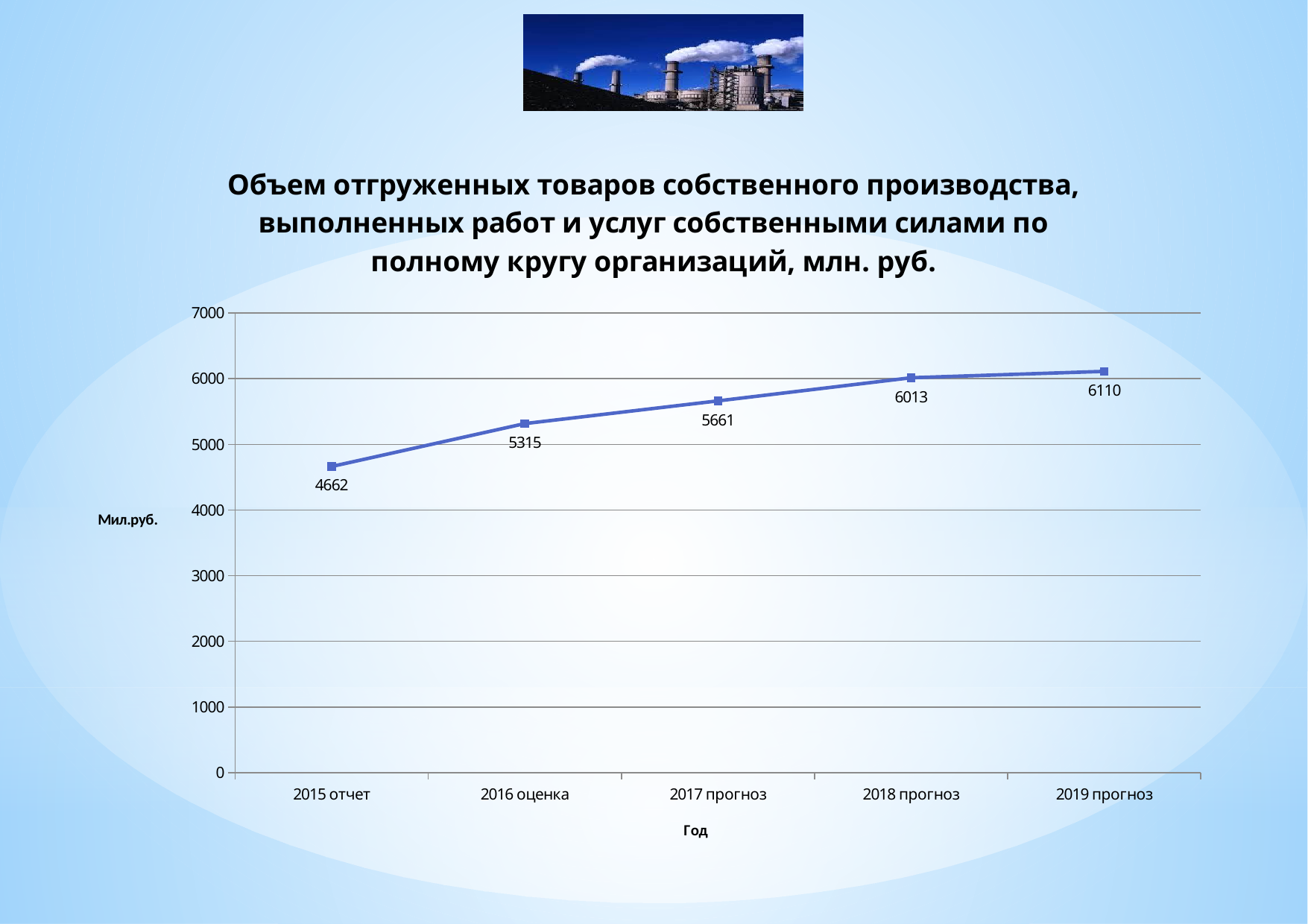
Which year has the lowest value? 2015 отчет How many data points are plotted on the chart? 5 Do the values rise or fall from 2015 to 2019? rise What is the value for 2017 прогноз? 5661 Which year has the highest value? 2019 прогноз What is the value for 2015 отчет? 4662 What kind of chart is shown on the slide? line chart Which is larger, the value for 2017 прогноз or the value for 2016 оценка? 2017 прогноз What is the difference between the values for 2016 оценка and 2015 отчет? 653 What is the difference between the values for 2019 прогноз and 2018 прогноз? 97 Is the value for 2018 прогноз greater or less than 5000? greater What is the value for 2019 прогноз? 6110